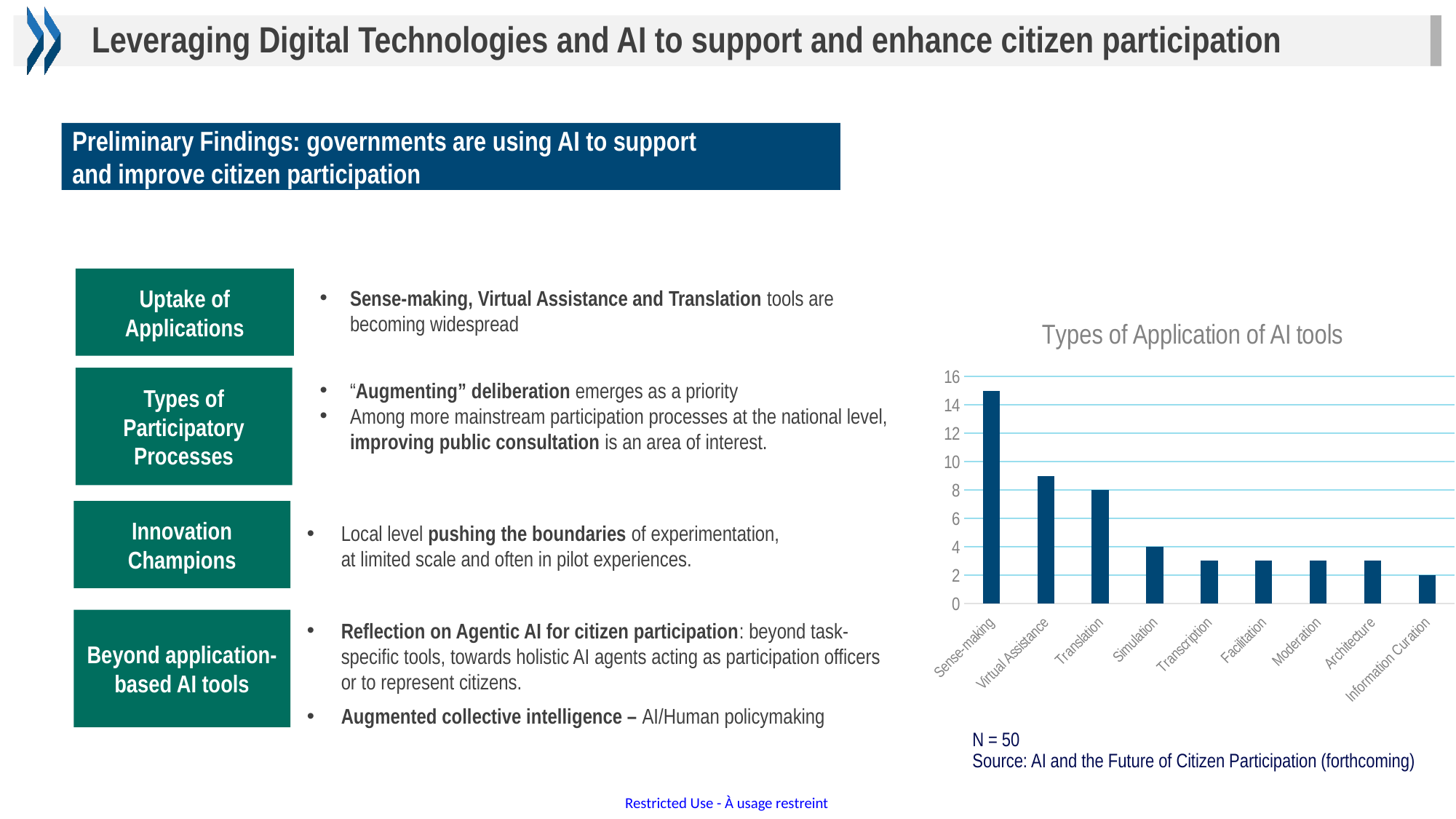
Do the values rise or fall moving from left to right along the x axis? fall What is the value for Information Curation? 2 Which category has the highest value in the chart? Sense-making What is the value for Simulation? 4 What kind of chart is shown on the slide? bar chart What is the value for Translation? 8 Is the value for Virtual Assistance greater or less than 10? less How many categories are shown on the x axis of the chart? 9 Is the value for Sense-making greater or less than 14? greater Which category has the lowest value in the chart? Information Curation What is the title of the chart on the slide? Types of Application of AI tools What is the difference between the values for Translation and Simulation? 4